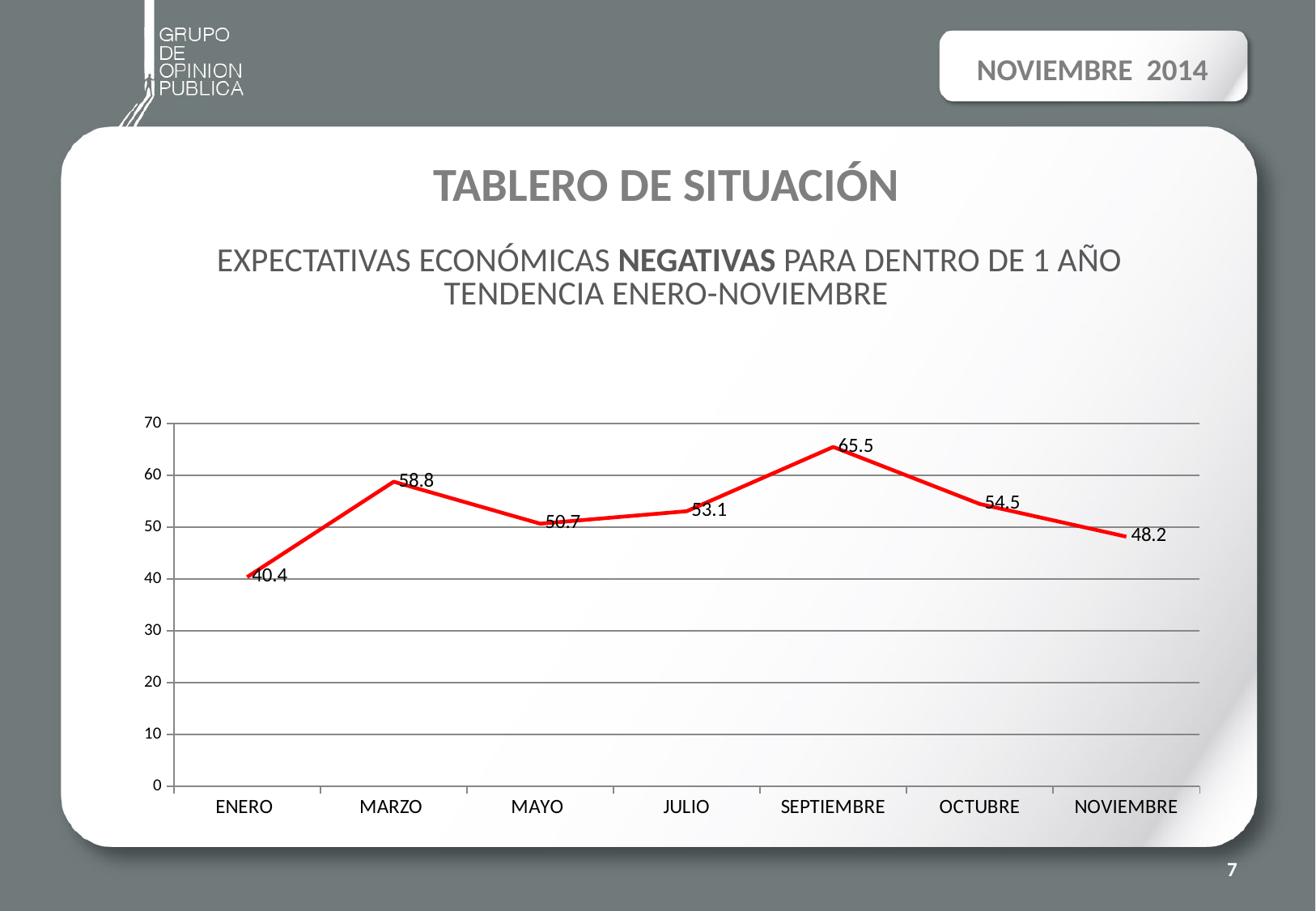
What is the value for NOVIEMBRE? 48.2 Which month has the lowest value? ENERO Which is larger, the value for OCTUBRE or the value for JULIO? OCTUBRE How many months are plotted on the chart? 7 What is the value for ENERO? 40.4 Is the value for MAYO greater or less than 60? less What kind of chart is shown on the slide? line chart Which month has the highest value? SEPTIEMBRE Does the value rise or fall from SEPTIEMBRE to NOVIEMBRE? fall What is the difference between the values for MARZO and MAYO? 8.1 What is the value for SEPTIEMBRE? 65.5 What is the difference between the values for SEPTIEMBRE and NOVIEMBRE? 17.3